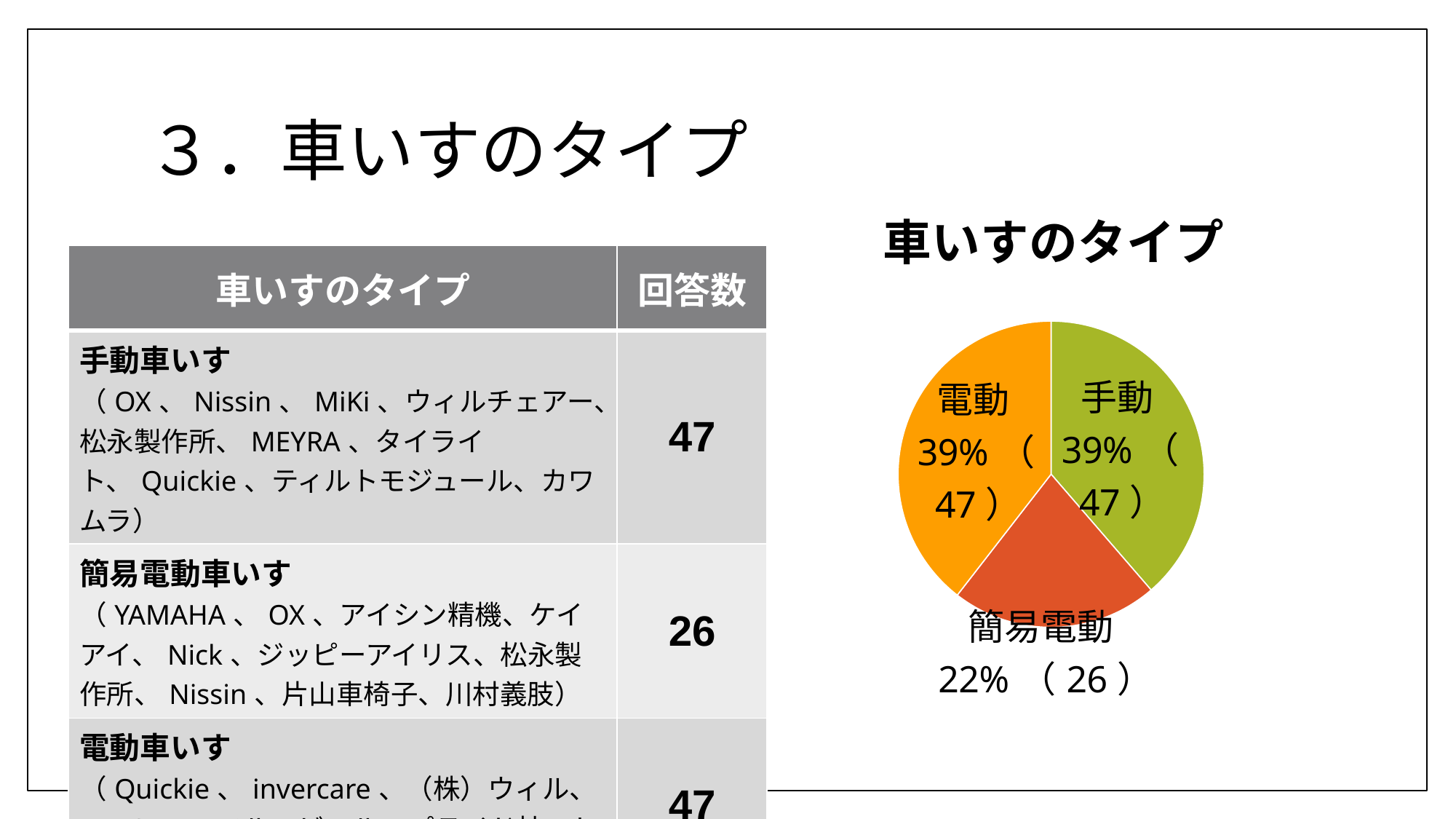
How many slices does the pie chart have? 3 Which category has the smallest slice in the pie chart? 簡易電動 What is the count shown for 電動 in the pie chart? 47 What colour is the 簡易電動 slice in the pie chart? red-orange What is the count shown for 手動 in the pie chart? 47 What percentage share does 手動 have in the pie chart? 39% Which is larger in the pie chart, 電動 or 簡易電動? 電動 What is the title of the pie chart? 車いすのタイプ What is the difference between the counts for 手動 and 簡易電動 in the pie chart? 21 What kind of chart is shown on the slide? pie chart What percentage share does 簡易電動 have in the pie chart? 22% What is the count shown for 簡易電動 in the pie chart? 26